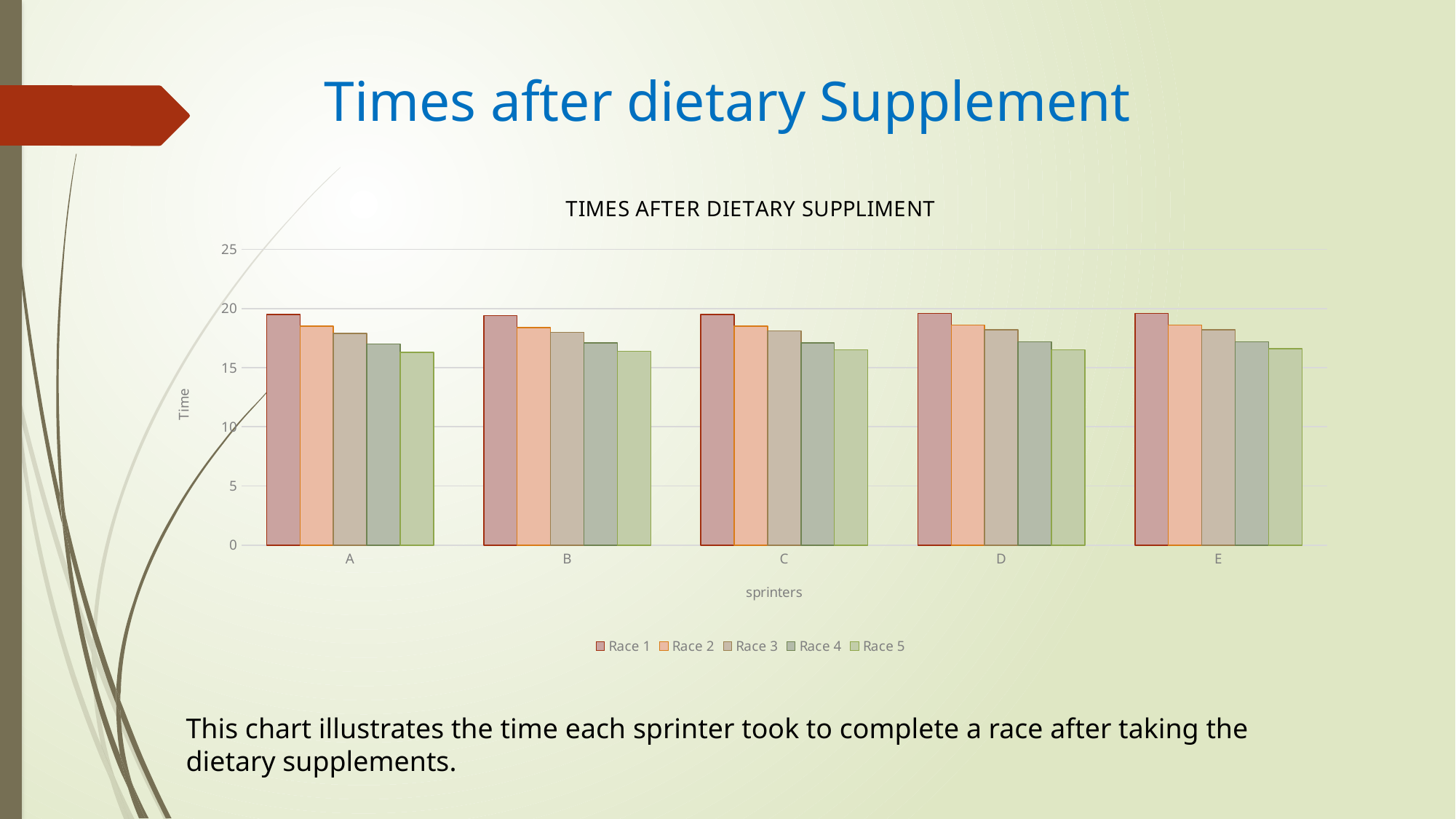
What is the label on the vertical axis of the chart? Time What kind of chart is shown on the slide? bar chart Is the Race 3 value for sprinter E greater or less than 15? greater Is the Race 5 value for sprinter C greater or less than 20? less For sprinter A, which is larger: the Race 1 value or the Race 5 value? Race 1 How many sprinters are shown on the x axis of the chart? 5 Is the Race 1 value for sprinter A greater or less than 15? greater How many series does the chart legend list? 5 What is the title of the chart? TIMES AFTER DIETARY SUPPLIMENT For sprinter B, which race has the highest time? Race 1 For sprinter D, which race has the lowest time? Race 5 Within each sprinter's group, do the times rise or fall from Race 1 to Race 5? fall